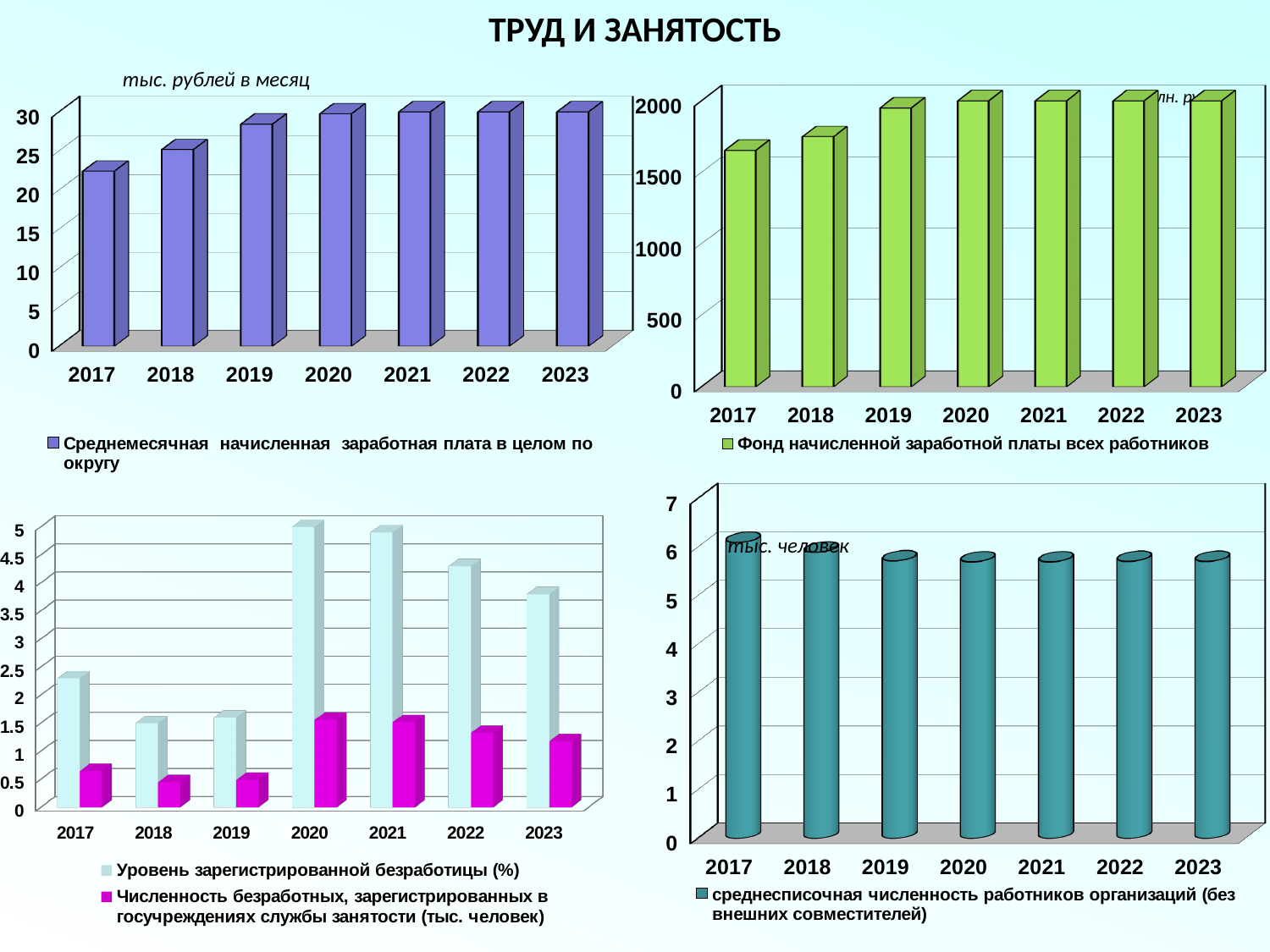
In the bottom-right chart (среднесписочная численность работников организаций), which year has the highest value? 2017 In the top-left chart (Среднемесячная начисленная заработная плата), is the value for 2017 greater or less than 25? less How many series does the legend of the bottom-left chart (Уровень зарегистрированной безработицы) list? 2 In the bottom-left chart, which is larger: Уровень зарегистрированной безработицы (%) for 2020 or for 2017? 2020 In the top-right chart (Фонд начисленной заработной платы всех работников), is the value for 2018 greater or less than 2000? less In the bottom-right chart (среднесписочная численность работников организаций), is the value for 2019 greater or less than 6? less How many years are shown on the x axis of the top-left chart (Среднемесячная начисленная заработная плата)? 7 In the top-right chart (Фонд начисленной заработной платы всех работников), which year has the lowest value? 2017 In the top-left chart (Среднемесячная начисленная заработная плата), which year has the lowest value? 2017 What kind of chart is the top-left chart (Среднемесячная начисленная заработная плата в целом по округу)? bar chart In the top-left chart (Среднемесячная начисленная заработная плата), do the values generally rise or fall from 2017 to 2023? rise